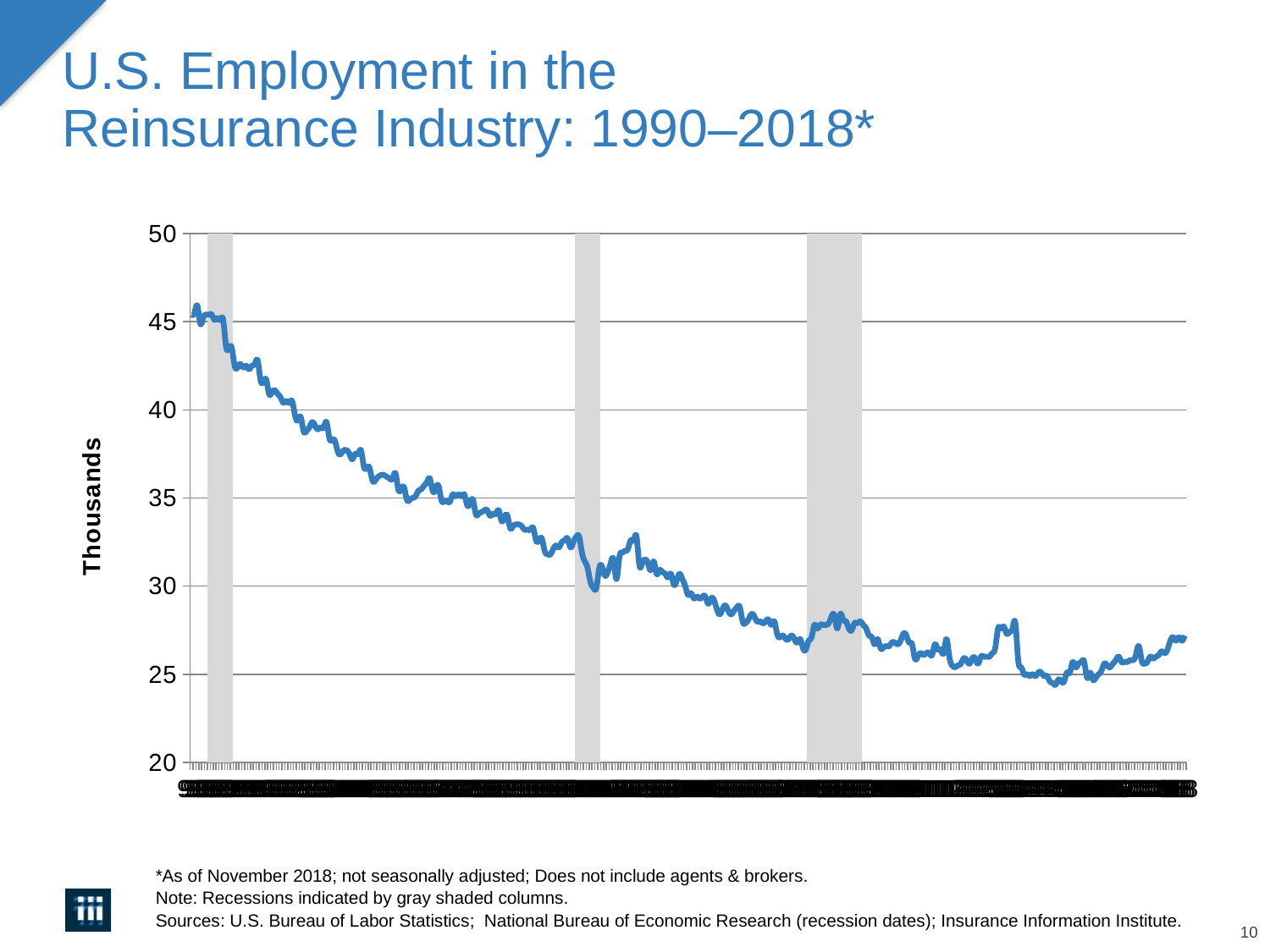
Overall, do the values rise or fall from 1990 to 2018? fall Is the value at the end of the series (2018) greater or less than 30? less Which is larger, the value at the start of the series or the value at the end of the series? the value at the start Is the value at the start of the series (1990) greater or less than 40? greater Is the highest point on the line greater or less than 45? greater What is the label on the vertical axis? Thousands What kind of chart is shown on the slide? line chart How many gray shaded recession columns are shown on the chart? 3 What is the highest value shown on the vertical axis? 50